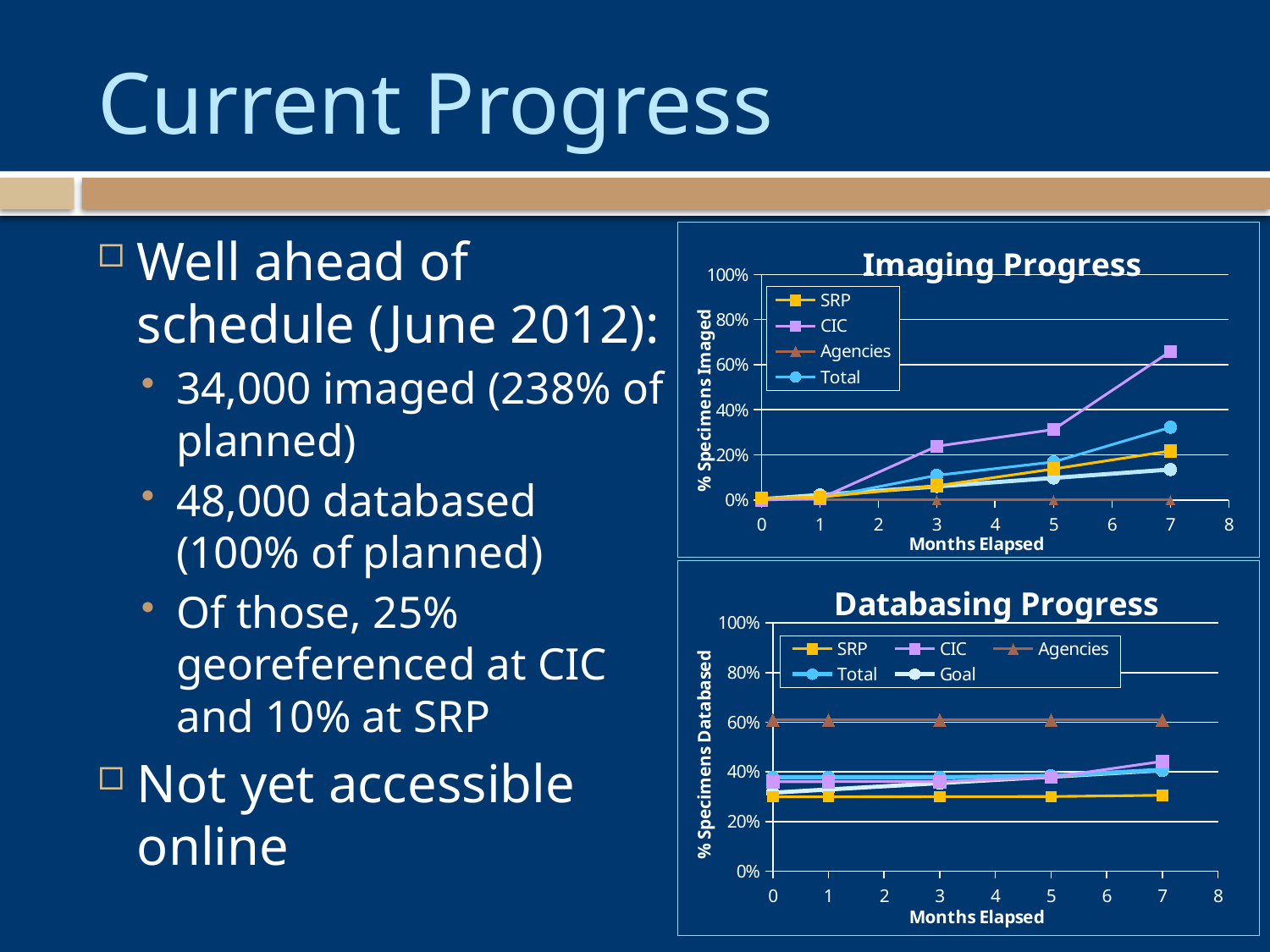
In the Databasing Progress chart, which series has the highest values across all months? Agencies In the Imaging Progress chart, is the CIC value at month 7 greater or less than 60%? greater How many series does the legend of the Imaging Progress chart list? 4 In the Databasing Progress chart, is the Agencies value at month 7 greater or less than 40%? greater How many series does the legend of the Databasing Progress chart list? 5 In the Databasing Progress chart, which series has the lowest value at month 7? SRP In the Imaging Progress chart, which series has the highest value at month 7? CIC In the Imaging Progress chart, does the CIC series rise or fall as months elapse? rise In the Imaging Progress chart, what is the Agencies value at month 7? 0% In the Imaging Progress chart, is the Total value at month 7 greater or less than 40%? less What is the x-axis title of the Databasing Progress chart? Months Elapsed What kind of chart is the Imaging Progress chart? line chart